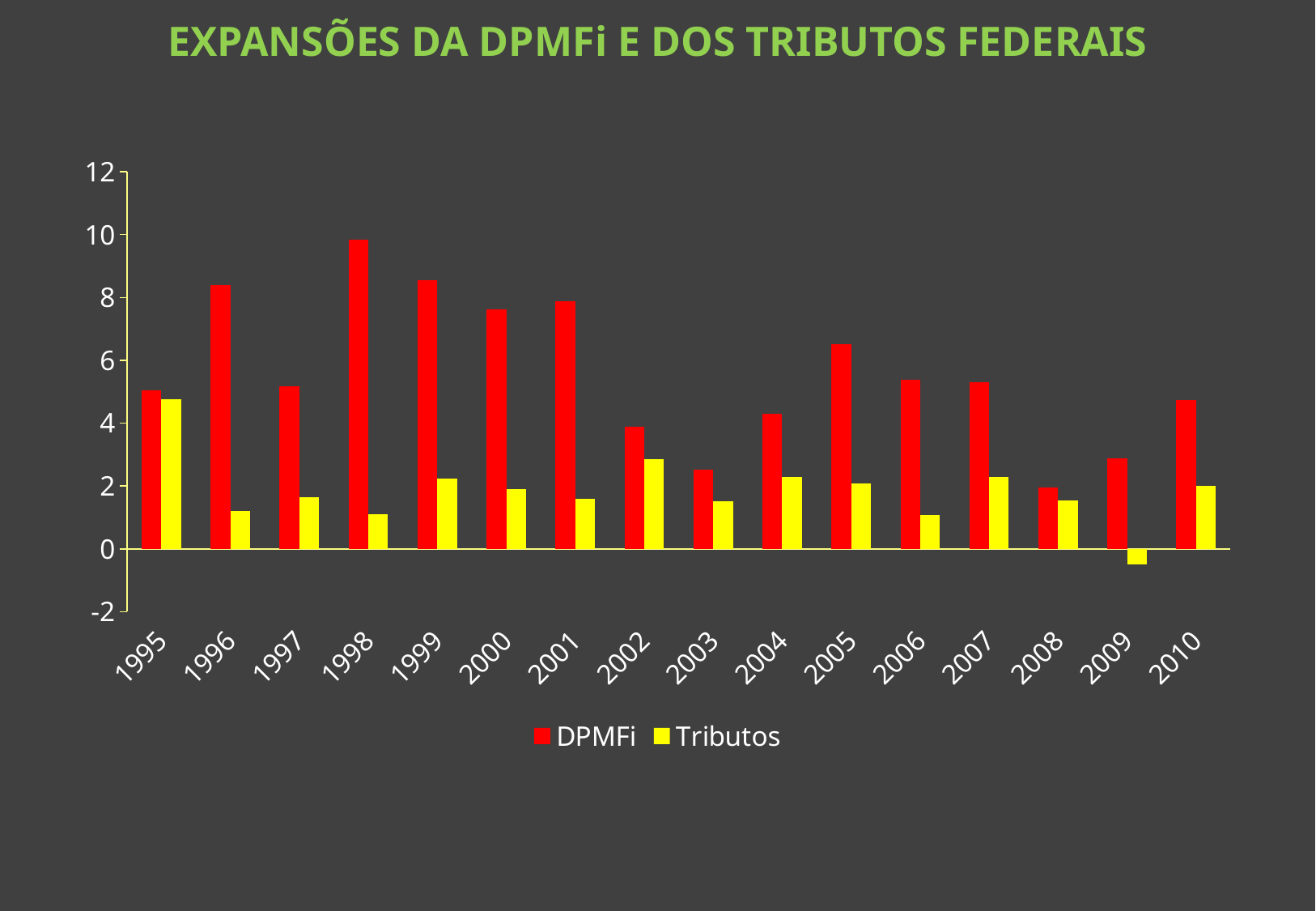
Is the DPMFi value for 2005 greater or less than 6? greater In which year is the Tributos value highest? 1995 Is the DPMFi value for 1998 greater or less than 8? greater Which is larger in 2002, the DPMFi value or the Tributos value? DPMFi Is the Tributos value for 1997 greater or less than 2? less How many series does the legend list? 2 Which colour represents the Tributos series? yellow What kind of chart is shown on the slide? bar chart In which year is the Tributos value lowest? 2009 How many years are shown on the x axis? 16 In which year is the DPMFi value highest? 1998